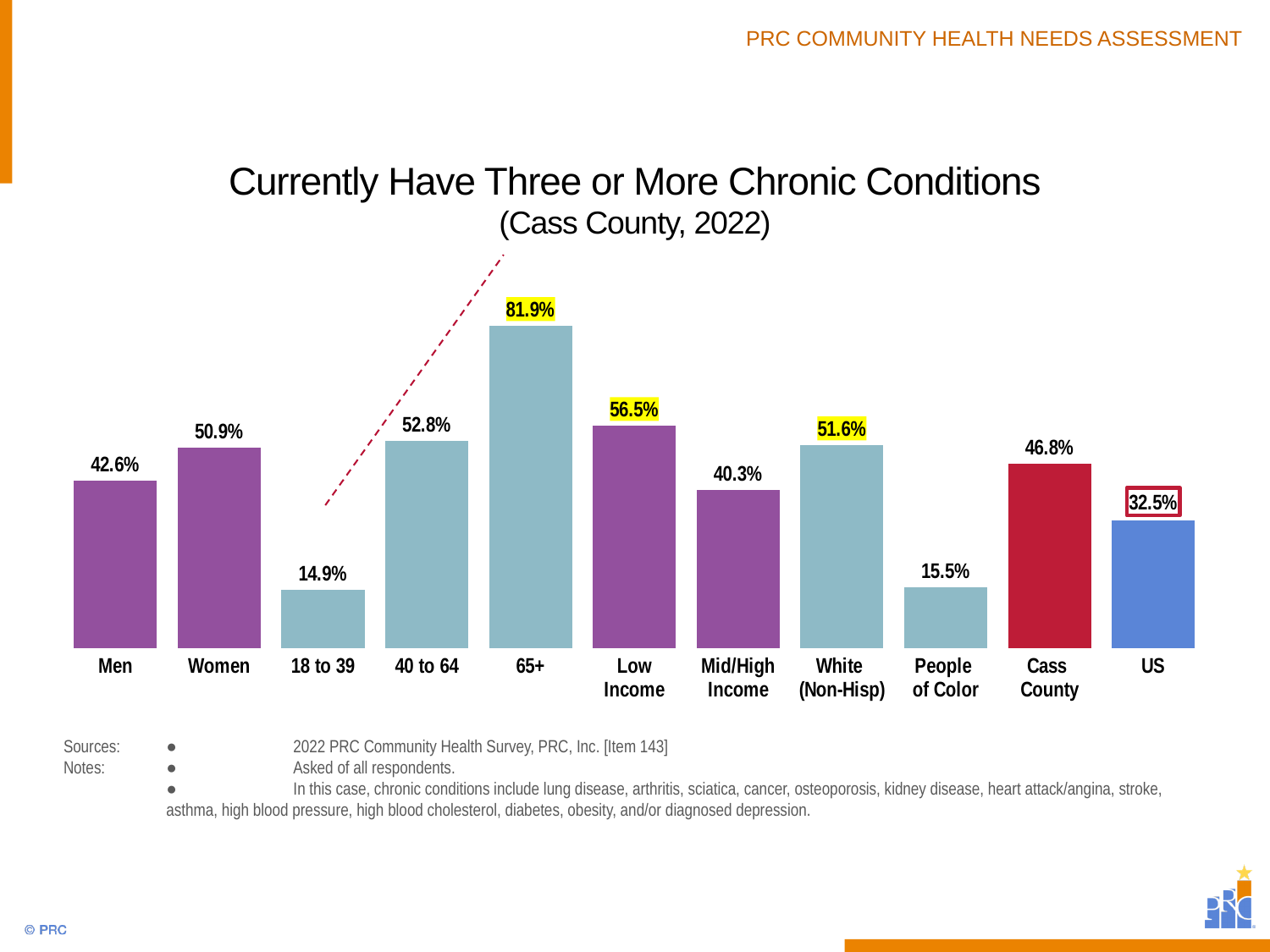
What is the value for the US? 32.5% What is the title of the chart? Currently Have Three or More Chronic Conditions (Cass County, 2022) Which category has the lowest value? 18 to 39 What kind of chart is this? Bar chart What is the difference between the values for Women and Men? 8.3% What is the difference between the values for Cass County and the US? 14.3% Which category has the highest value? 65+ Which is larger, the value for Low Income or Mid/High Income? Low Income What is the value for Men? 42.6% What is the value for Cass County? 46.8% How many categories are shown in the chart? 11 What is the value for the 18 to 39 age group? 14.9%